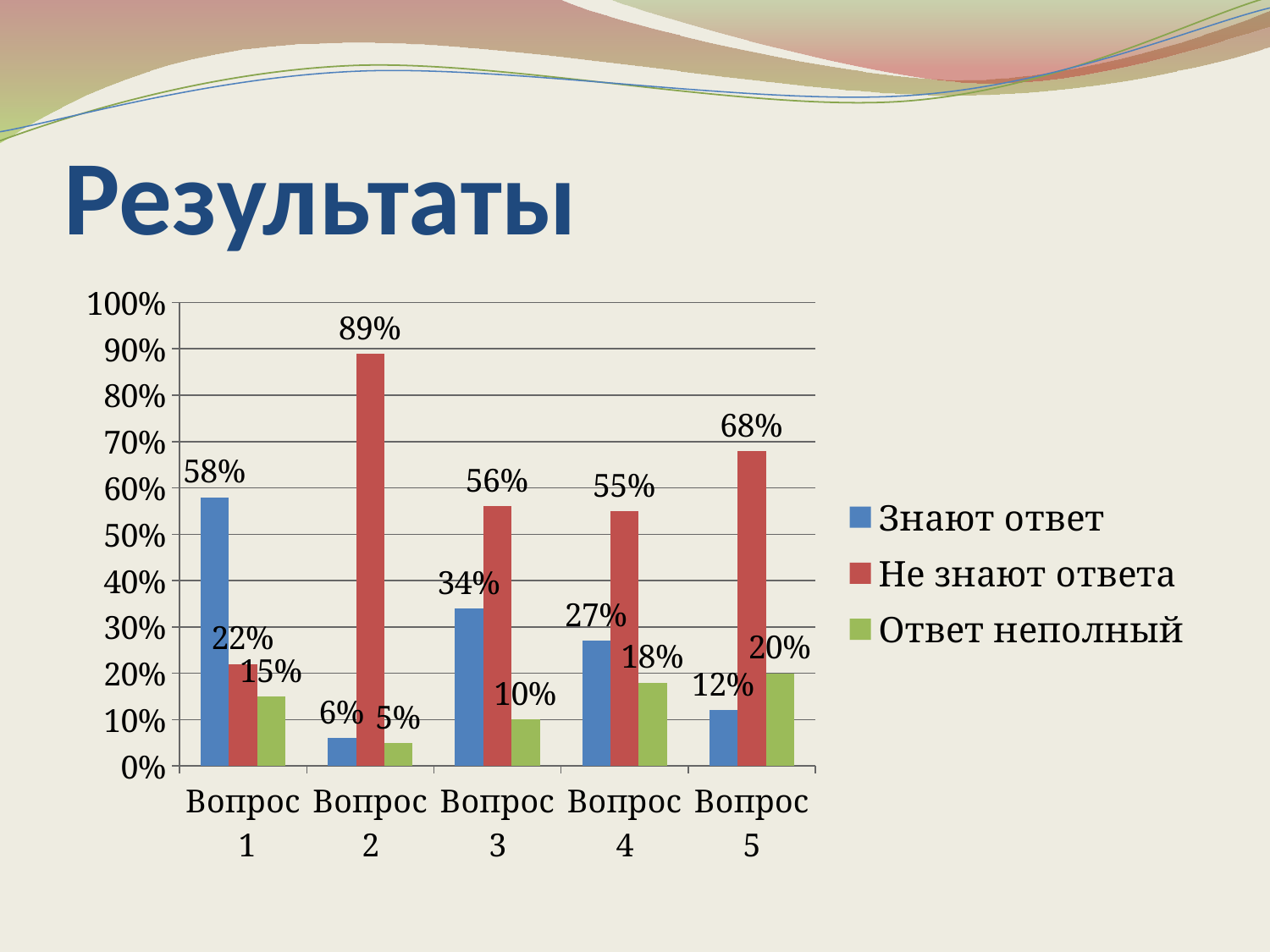
What is the difference between "Не знают ответа" and "Знают ответ" for Вопрос 5? 56% What is the value for "Ответ неполный" for Вопрос 5? 20% Which is larger for Вопрос 1: "Знают ответ" or "Не знают ответа"? Знают ответ Which question has the highest value for "Не знают ответа"? Вопрос 2 What kind of chart is shown on the slide? Bar chart How many questions (categories) are shown on the x axis? 5 How many series does the legend list? 3 What is the title of the slide? Результаты What is the value for "Знают ответ" for Вопрос 1? 58% What is the value for "Не знают ответа" for Вопрос 2? 89% Which question has the lowest value for "Знают ответ"? Вопрос 2 Which colour represents "Ответ неполный" in the legend? Green